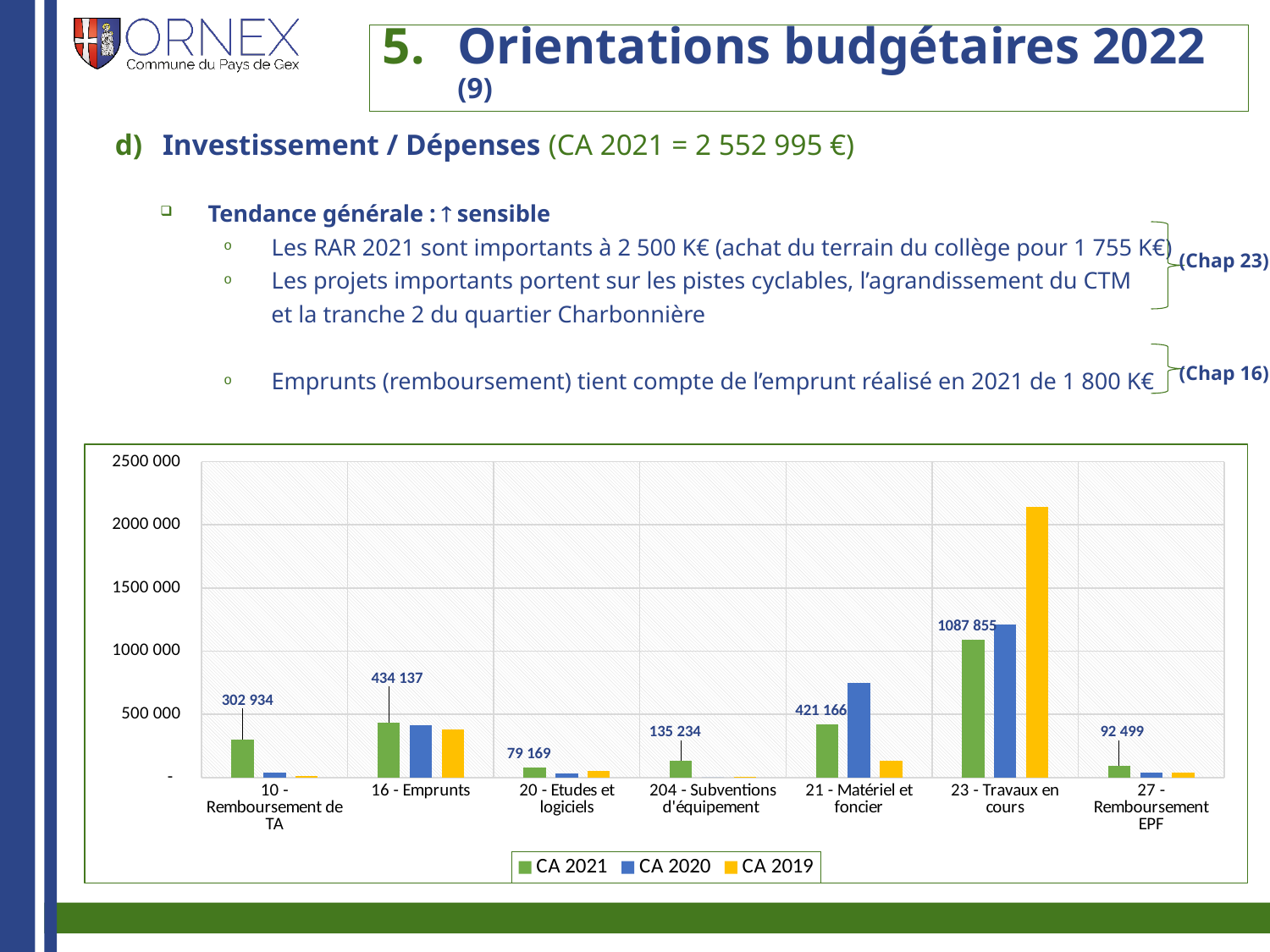
Is the CA 2019 value for 23 - Travaux en cours greater or less than 2000 000? greater What is the CA 2021 value for 20 - Etudes et logiciels? 79 169 What is the difference between the CA 2021 values for 16 - Emprunts and 10 - Remboursement de TA? 131 203 What kind of chart is shown on the slide? bar chart Which has the larger CA 2021 value, 16 - Emprunts or 21 - Matériel et foncier? 16 - Emprunts What is the CA 2021 value for 16 - Emprunts? 434 137 Which category has the lowest CA 2021 value? 20 - Etudes et logiciels How many categories are shown on the x axis of the chart? 7 Which category has the highest CA 2021 value? 23 - Travaux en cours How many series does the chart's legend list? 3 Is the CA 2020 value for 21 - Matériel et foncier greater or less than 500 000? greater What is the CA 2021 value for 23 - Travaux en cours? 1087 855